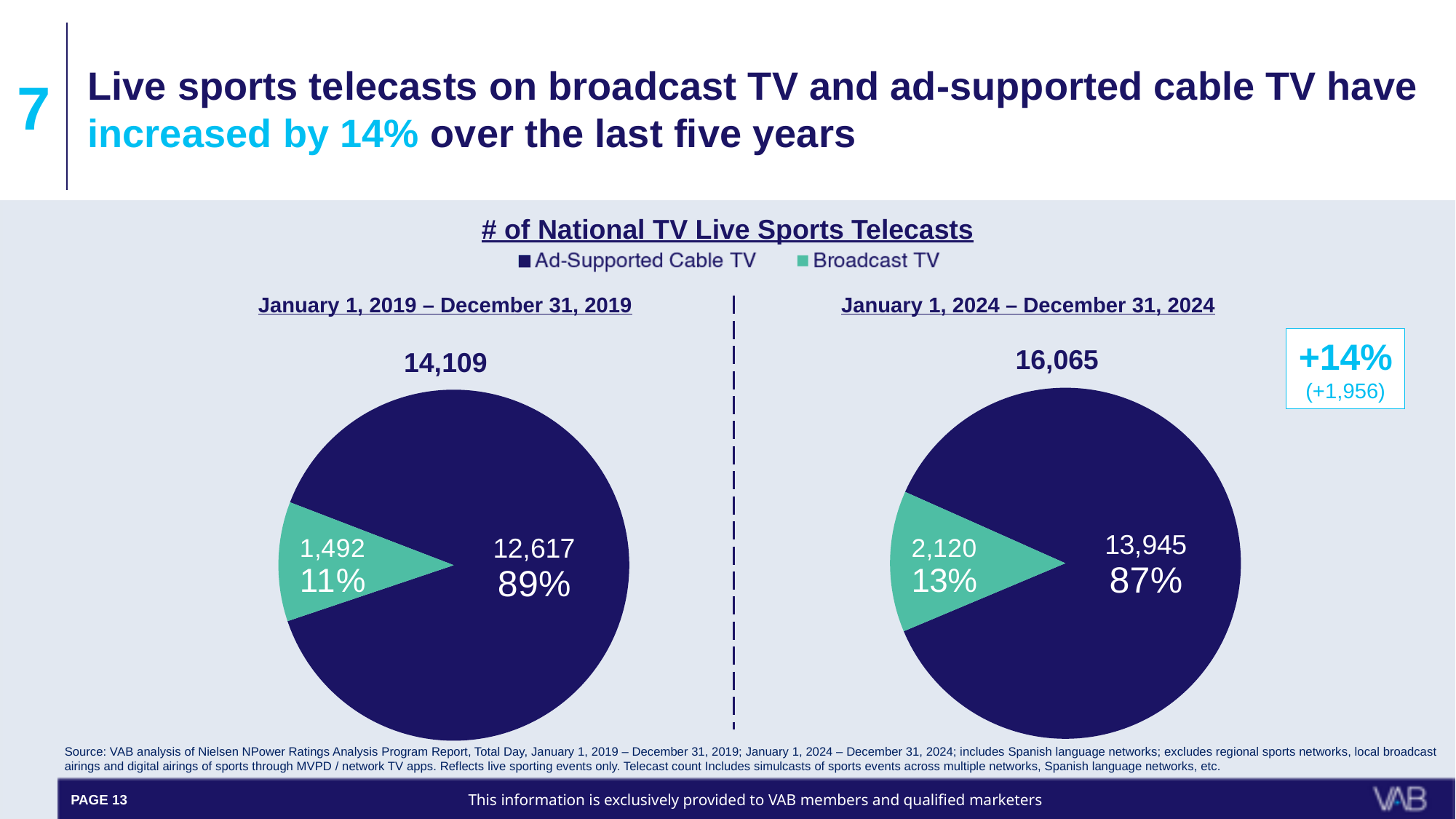
In the 2019 pie chart, how many live sports telecasts were on Broadcast TV? 1,492 What type of chart is used to show the number of National TV live sports telecasts? Pie chart In the 2019 pie chart (January 1, 2019 – December 31, 2019), how many live sports telecasts were on Ad-Supported Cable TV? 12,617 In the 2019 pie chart, what share of telecasts does Ad-Supported Cable TV account for? 89% What is the total number of National TV live sports telecasts shown for the 2024 pie chart? 16,065 What is the difference in Broadcast TV telecasts between the 2024 pie chart and the 2019 pie chart? 628 What is the total number of National TV live sports telecasts shown for the 2019 pie chart? 14,109 In the 2024 pie chart, how many live sports telecasts were on Broadcast TV? 2,120 In the 2024 pie chart (January 1, 2024 – December 31, 2024), how many live sports telecasts were on Ad-Supported Cable TV? 13,945 How many series does the legend list for the National TV live sports telecasts charts? 2 In the 2024 pie chart, what share of telecasts does Broadcast TV account for? 13% In the 2024 pie chart, which segment is larger, Ad-Supported Cable TV or Broadcast TV? Ad-Supported Cable TV